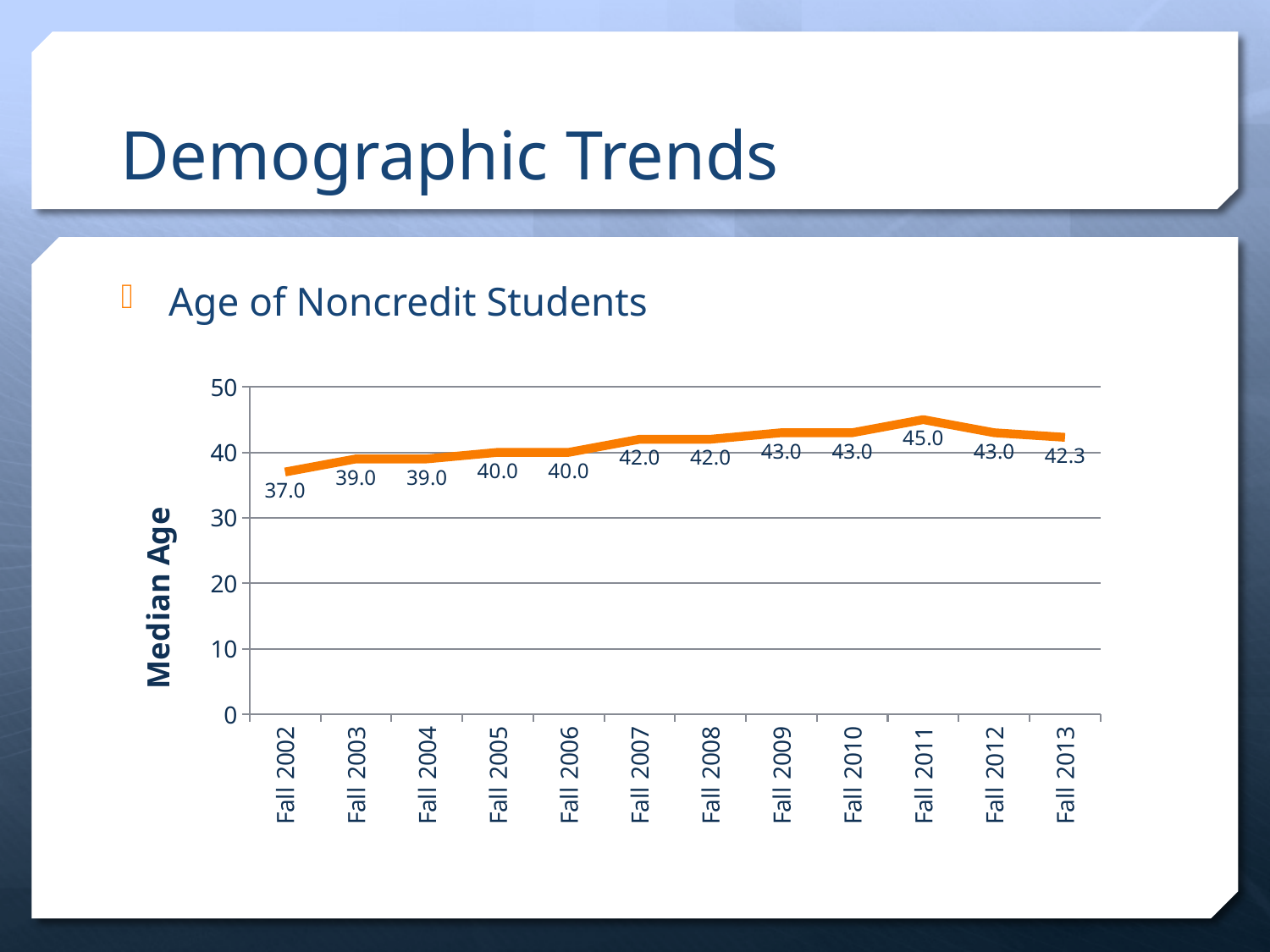
What is the label on the vertical axis of the chart? Median Age Which term has the lowest median age of noncredit students? Fall 2002 What is the median age of noncredit students in Fall 2013? 42.3 Does the median age generally rise or fall from Fall 2002 to Fall 2011? rise What kind of chart is shown on the slide? line chart How many terms are plotted on the chart? 12 What is the median age of noncredit students in Fall 2011? 45.0 Is the median age for Fall 2005 greater or less than 30? greater Which term has the highest median age of noncredit students? Fall 2011 What is the median age of noncredit students in Fall 2002? 37.0 Which is larger, the median age in Fall 2007 or in Fall 2009? Fall 2009 What is the difference in median age between Fall 2011 and Fall 2002? 8.0